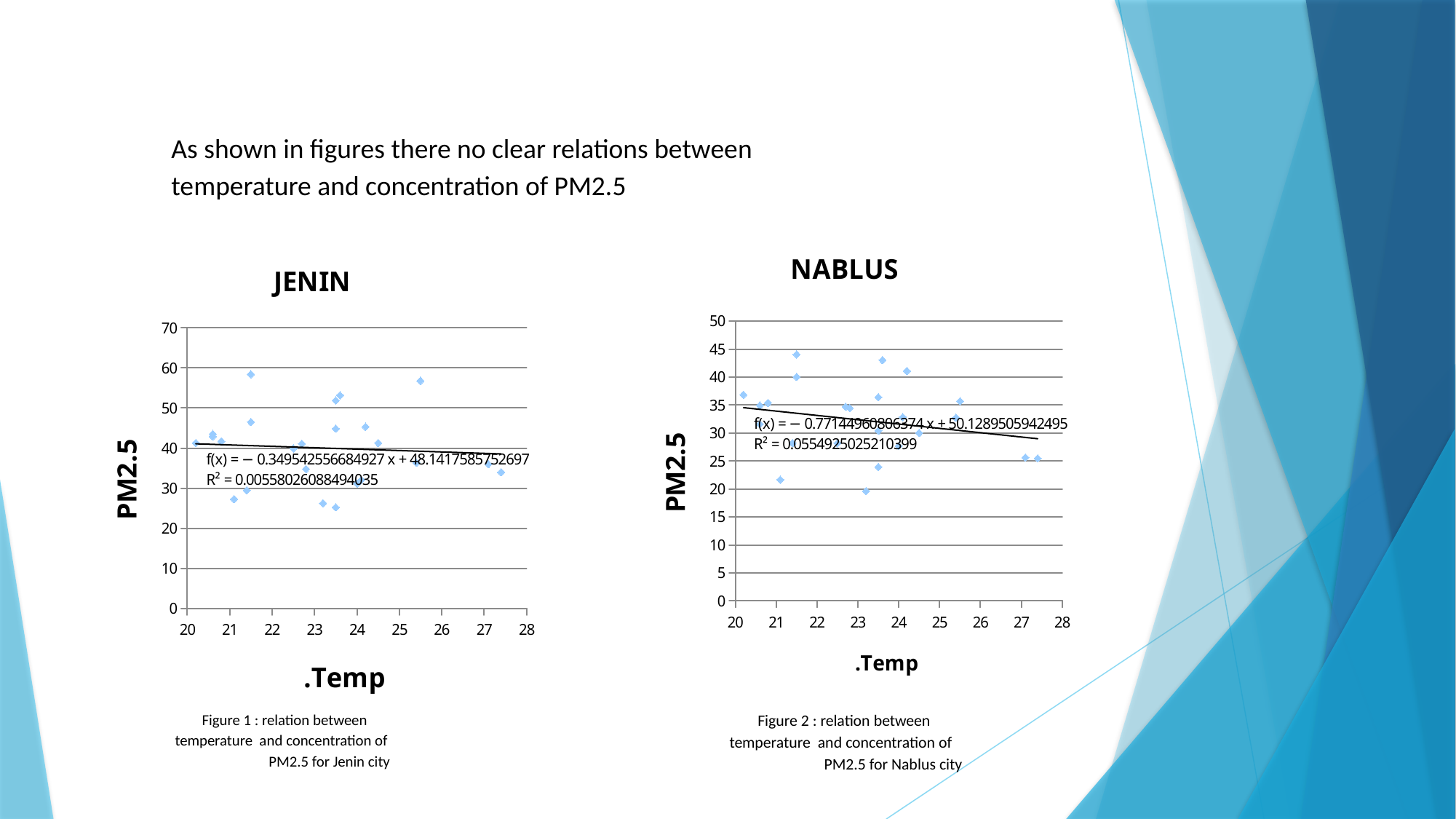
In the NABLUS chart, is the lowest plotted PM2.5 value greater or less than 25? less What kind of chart is the NABLUS chart? scatter chart In the NABLUS chart, does the fitted trendline rise or fall as temperature increases? fall What is the R² value shown on the NABLUS chart? 0.0554925025210399 What is the R² value shown on the JENIN chart? 0.00558026088494035 In the JENIN chart, is the highest plotted PM2.5 value greater or less than 50? greater What is the maximum value shown on the y axis of the JENIN chart? 70 What kind of chart is the JENIN chart? scatter chart In the JENIN chart, is the lowest plotted PM2.5 value greater or less than 30? less What is the label of the y axis on the NABLUS chart? PM2.5 In the JENIN chart, does the fitted trendline rise or fall as temperature increases? fall